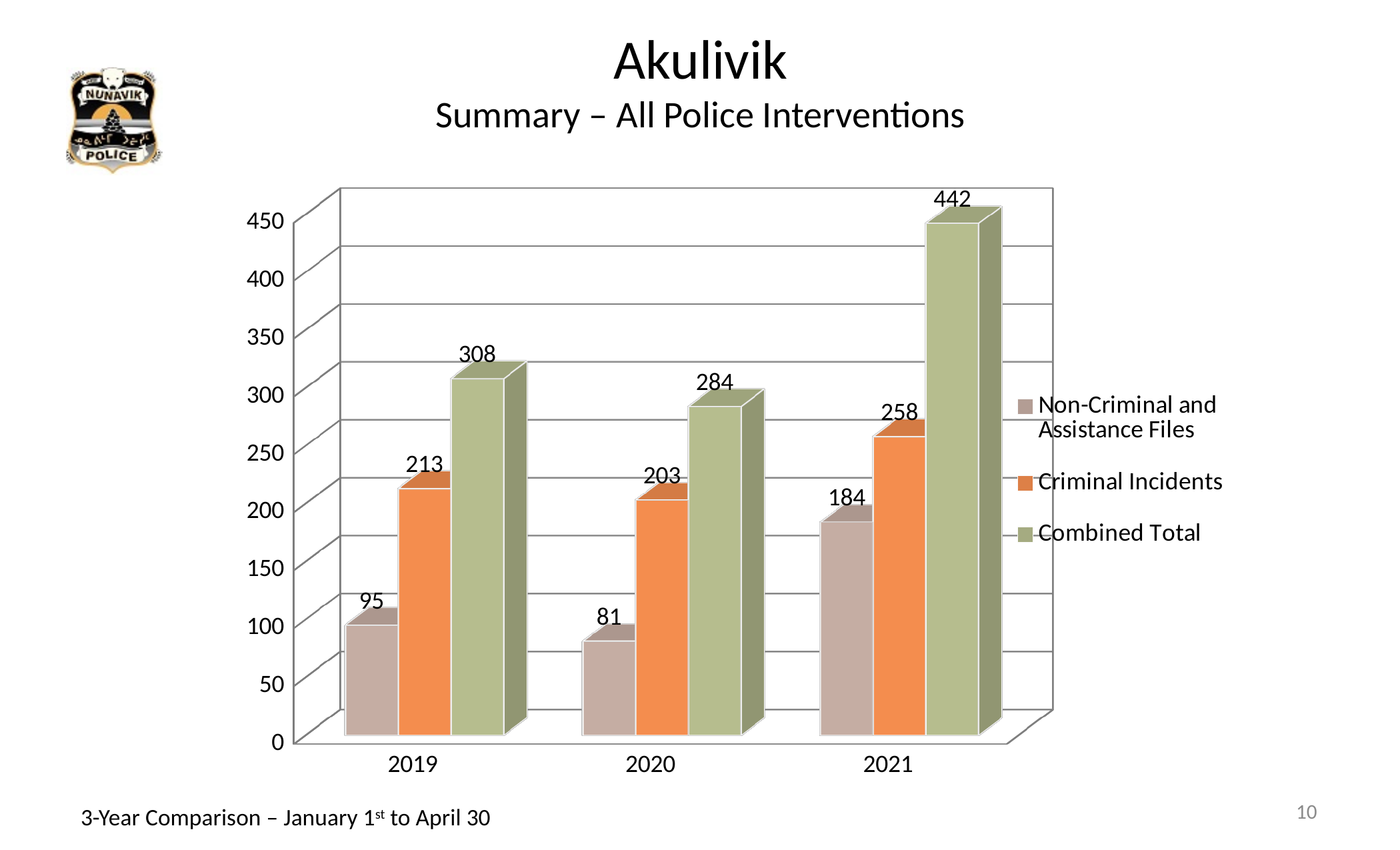
What is the Combined Total for 2019? 308 What is the value for Non-Criminal and Assistance Files in 2021? 184 Which is larger: Criminal Incidents in 2019 or Criminal Incidents in 2020? Criminal Incidents in 2019 What kind of chart is shown on the slide? Bar chart What is the value for Criminal Incidents in 2020? 203 What is the difference between Criminal Incidents in 2021 and in 2019? 45 Do the Criminal Incidents values rise or fall from 2020 to 2021? Rise How many series does the legend list? 3 Which year has the lowest value for Non-Criminal and Assistance Files? 2020 How many years are shown on the x axis? 3 What is the difference between the Combined Total in 2021 and in 2020? 158 Which year has the highest Combined Total? 2021